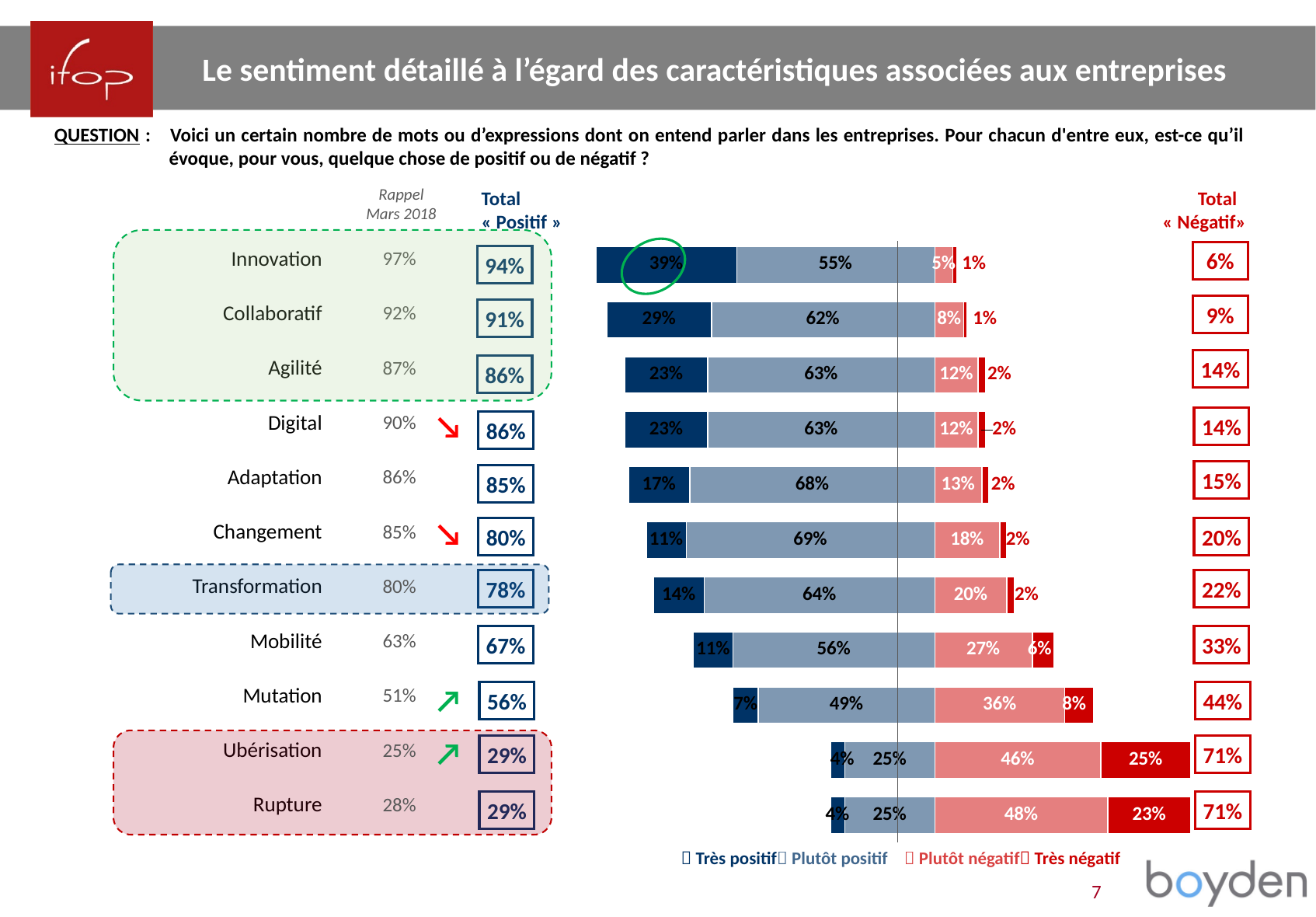
Which is larger, the "Plutôt négatif" value for Rupture or for Ubérisation? Rupture What is the difference between the "Plutôt positif" values for Changement and Mobilité? 13% How many series does the legend list? 4 Which category has the highest "Très positif" value? Innovation What is the "Plutôt négatif" value for Mutation? 36% What is the Total « Positif » value for Mobilité? 67% What is the Rappel Mars 2018 value for Mutation? 51% What is the "Très négatif" value for Ubérisation? 25% Which category has the lowest Total « Négatif » value? Innovation What is the "Très positif" value for Innovation? 39% What kind of chart is shown on the slide? Stacked bar chart How many categories are shown in the chart? 11